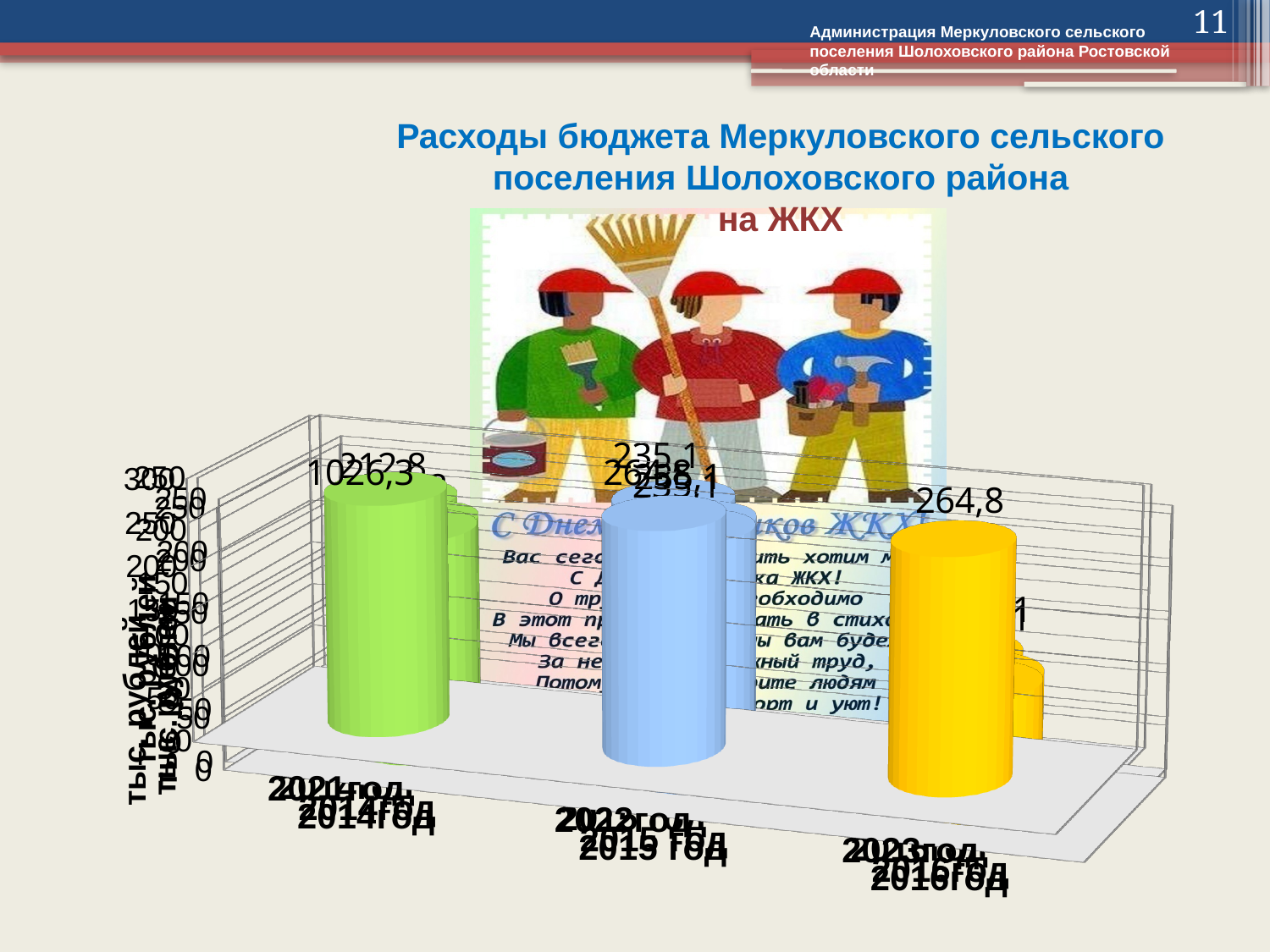
What is the title of the chart? Расходы бюджета Меркуловского сельского поселения Шолоховского района на ЖКХ What value is printed above the yellow bar? 264,8 What kind of chart is shown on the slide? bar chart What unit is given on the vertical axis of the chart? тыс. рублей